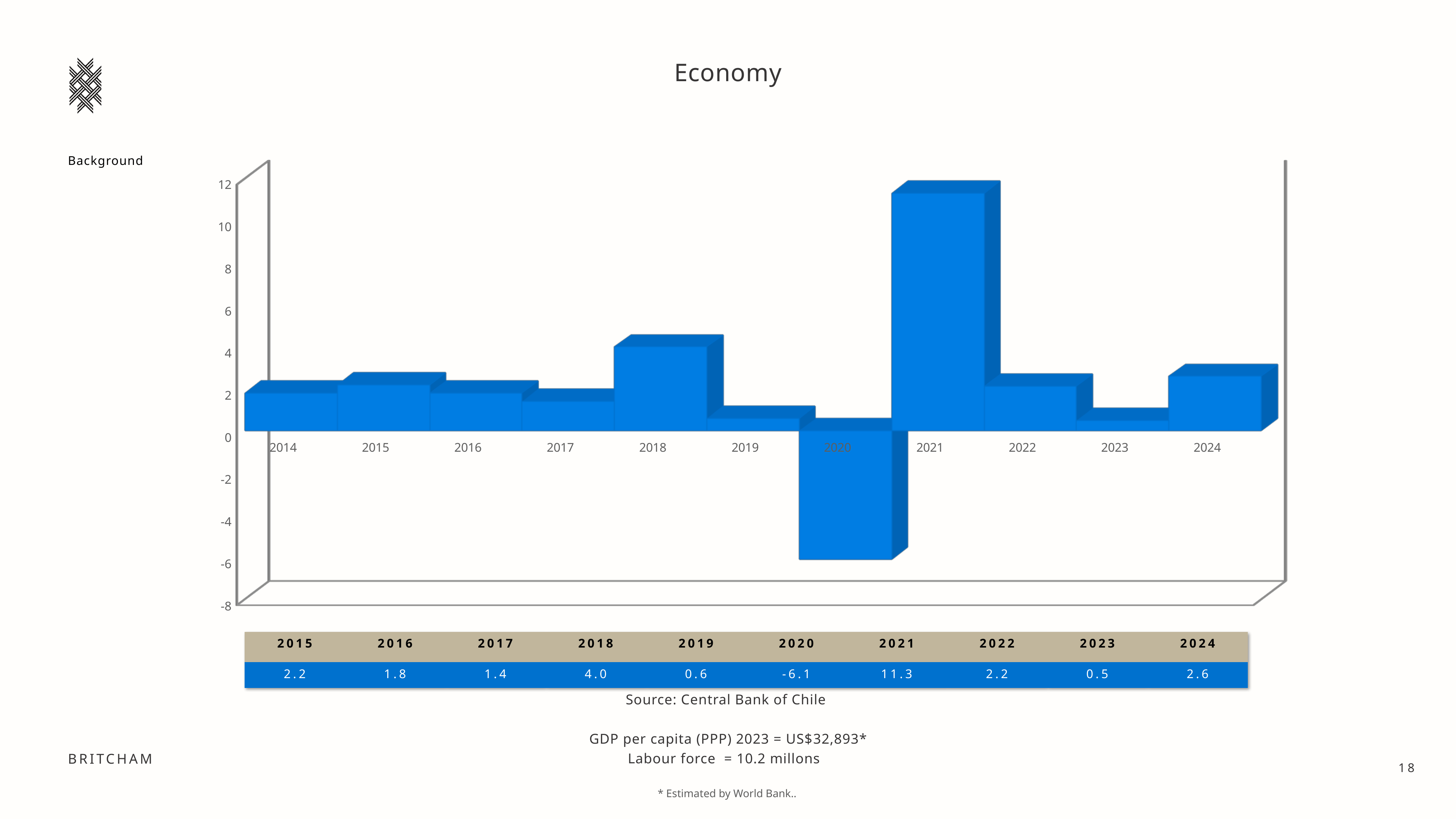
What is the difference between the values for 2021 and 2018? 7.3 Which year has the lowest value? 2020 What is the value for 2023? 0.5 Which year has the highest value? 2021 What kind of chart is shown on the slide? bar chart Is the value for 2014 greater or less than 4? less How many years are plotted on the x axis of the chart? 11 Which is larger, the value for 2018 or the value for 2024? 2018 What is the value for 2021? 11.3 Do the values rise or fall from 2021 to 2023? fall What is the value for 2018? 4.0 What is the value for 2020? -6.1